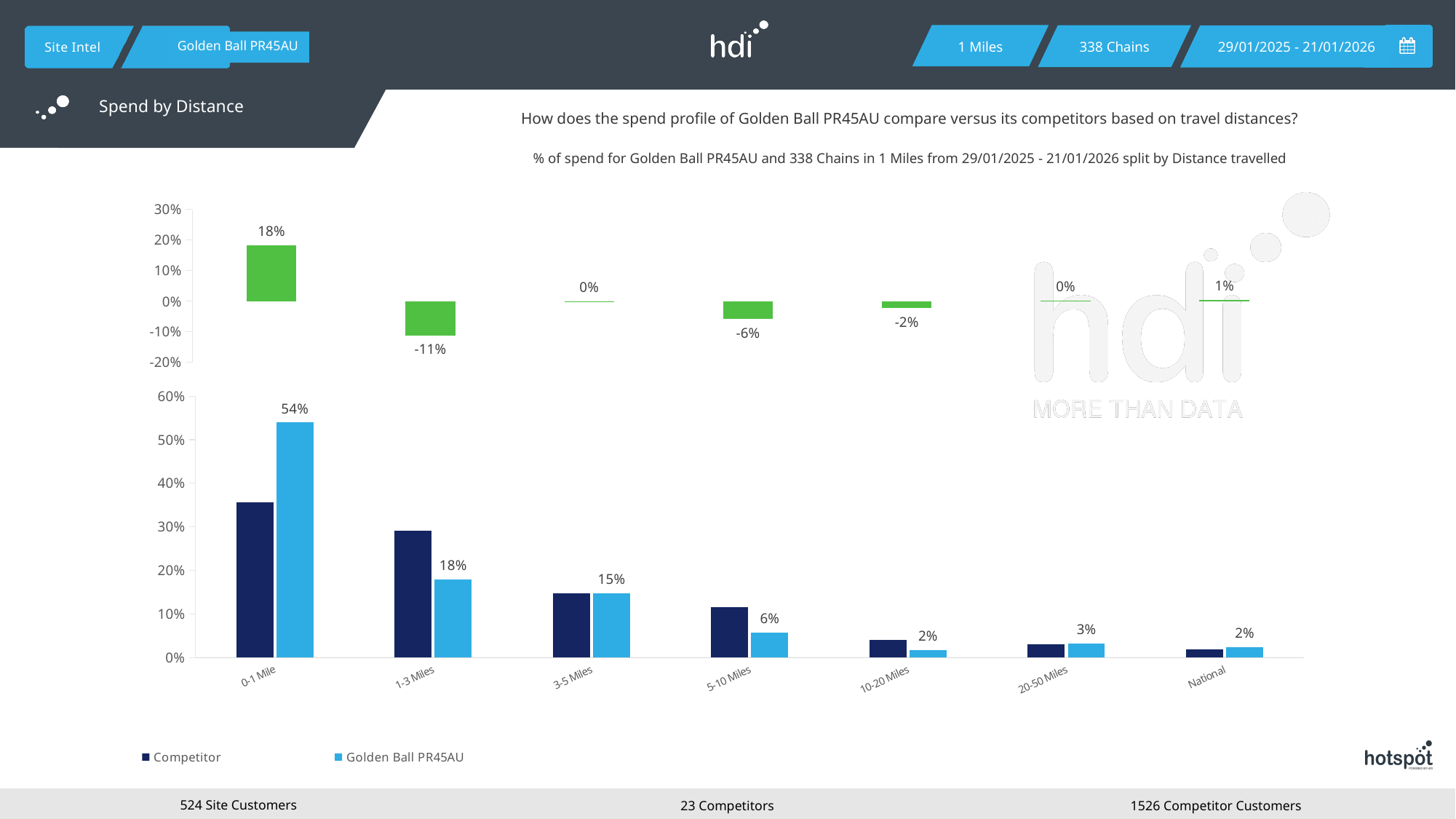
In the lower bar chart, what is the value for Golden Ball PR45AU in the 1-3 Miles category? 18% In the lower bar chart, what is the value for Golden Ball PR45AU in the 0-1 Mile category? 54% In the upper chart with green bars, what is the value of the leftmost bar? 18% In the lower bar chart, what is the value for Golden Ball PR45AU in the 5-10 Miles category? 6% In the lower bar chart, which category has the highest value for Golden Ball PR45AU? 0-1 Mile What kind of chart is the lower chart on the slide? bar chart In the lower bar chart, what is the difference between the Golden Ball PR45AU values for 0-1 Mile and 1-3 Miles? 36% How many series does the legend of the lower bar chart list? 2 In the upper chart with green bars, what is the lowest value shown? -11% In the lower bar chart, which series has the larger value in the 5-10 Miles category, Competitor or Golden Ball PR45AU? Competitor How many distance categories are shown on the x axis of the lower bar chart? 7 In the lower bar chart, is the Competitor value for 0-1 Mile greater or less than 30%? greater